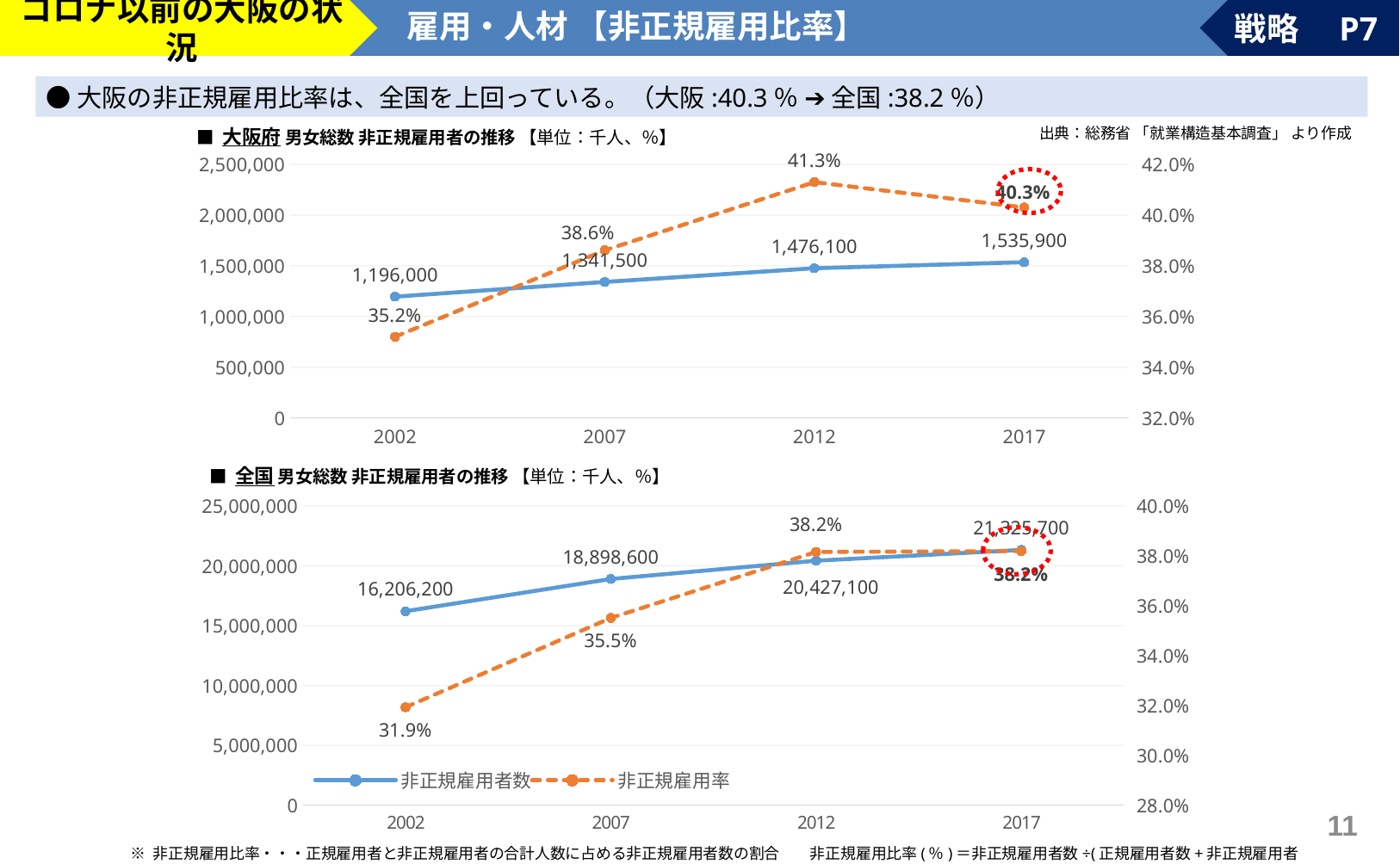
In the top chart (大阪府), which year has the highest non-regular employment rate? 2012 In the bottom chart (全国), what is the difference in the non-regular employment rate between 2012 and 2007? 2.7% In the top chart (大阪府), what is the difference in the number of non-regular employees between 2017 and 2002? 339,900 How many years (data points) are plotted on the x axis of the top chart (大阪府)? 4 In the top chart (大阪府), what is the non-regular employment rate (非正規雇用率) in 2012? 41.3% In the top chart (大阪府), what is the number of non-regular employees (非正規雇用者数) in 2017? 1,535,900 How many series does the legend on the bottom chart (全国) list? 2 In the bottom chart (全国), what is the non-regular employment rate in 2002? 31.9% What type of chart is the top chart (大阪府)? line chart In the bottom chart (全国), which year has the lowest number of non-regular employees? 2002 In the bottom chart (全国), does the number of non-regular employees rise or fall from 2002 to 2017? rise In the bottom chart (全国), what is the number of non-regular employees in 2007? 18,898,600